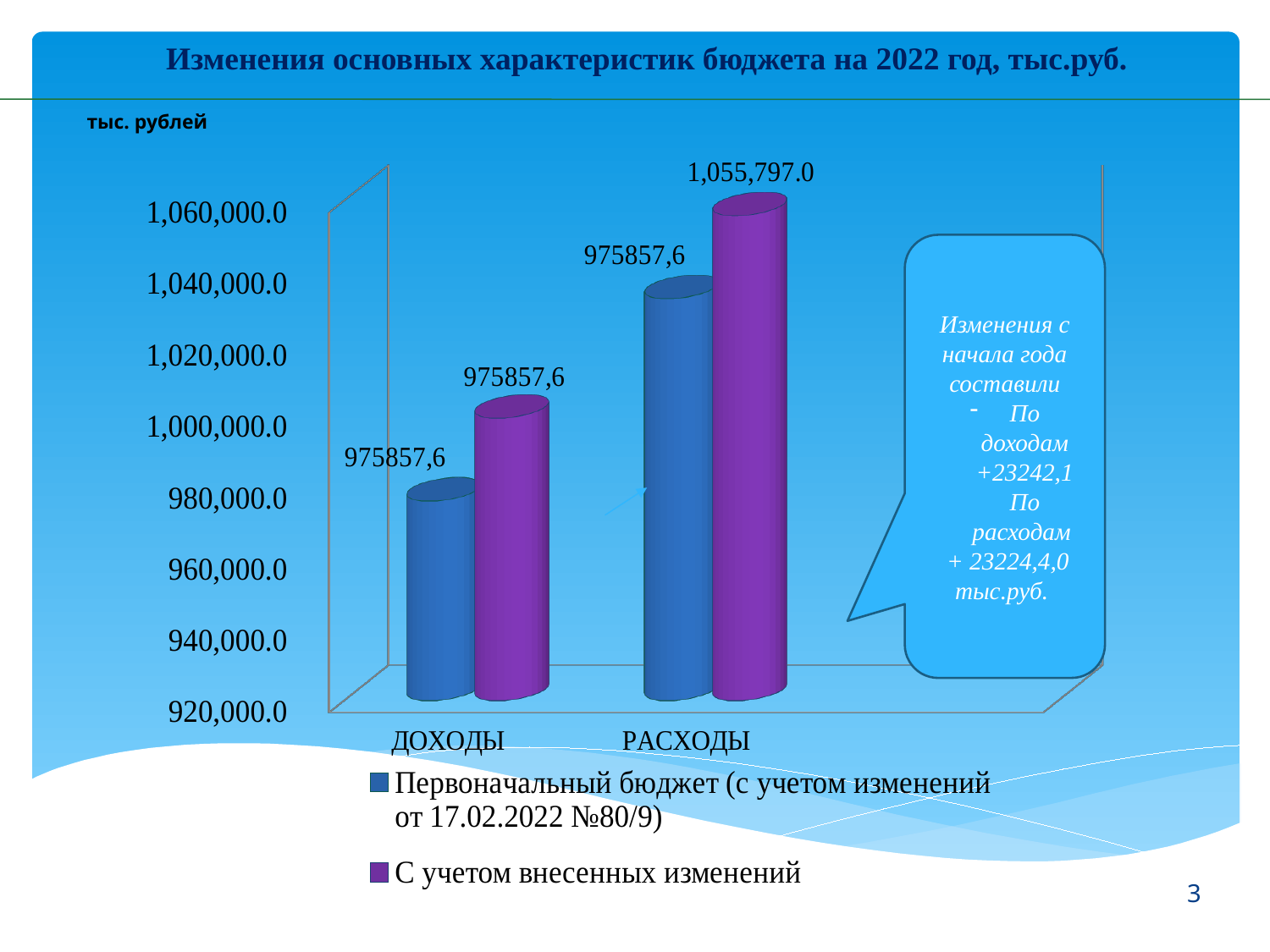
What type of chart is shown on the slide? bar chart What is the value labelled for ДОХОДЫ in the series 'Первоначальный бюджет (с учетом изменений от 17.02.2022 №80/9)'? 975857,6 What is the title of the chart on the slide? Изменения основных характеристик бюджета на 2022 год, тыс.руб. What is the name of the second series in the chart legend? С учетом внесенных изменений Is the value for ДОХОДЫ in the series 'Первоначальный бюджет (с учетом изменений от 17.02.2022 №80/9)' greater or less than 1,000,000.0? less How many categories are shown on the x axis of the chart? 2 How many series does the chart legend list? 2 What is the difference between the two labelled values for РАСХОДЫ (1,055,797.0 and 975857,6)? 79,939.4 What is the value labelled for РАСХОДЫ in the series 'Первоначальный бюджет (с учетом изменений от 17.02.2022 №80/9)'? 975857,6 Is the value for РАСХОДЫ in the series 'С учетом внесенных изменений' greater or less than 1,040,000.0? greater What is the value labelled for РАСХОДЫ in the series 'С учетом внесенных изменений'? 1,055,797.0 Which bar has the highest value in the chart? РАСХОДЫ, С учетом внесенных изменений